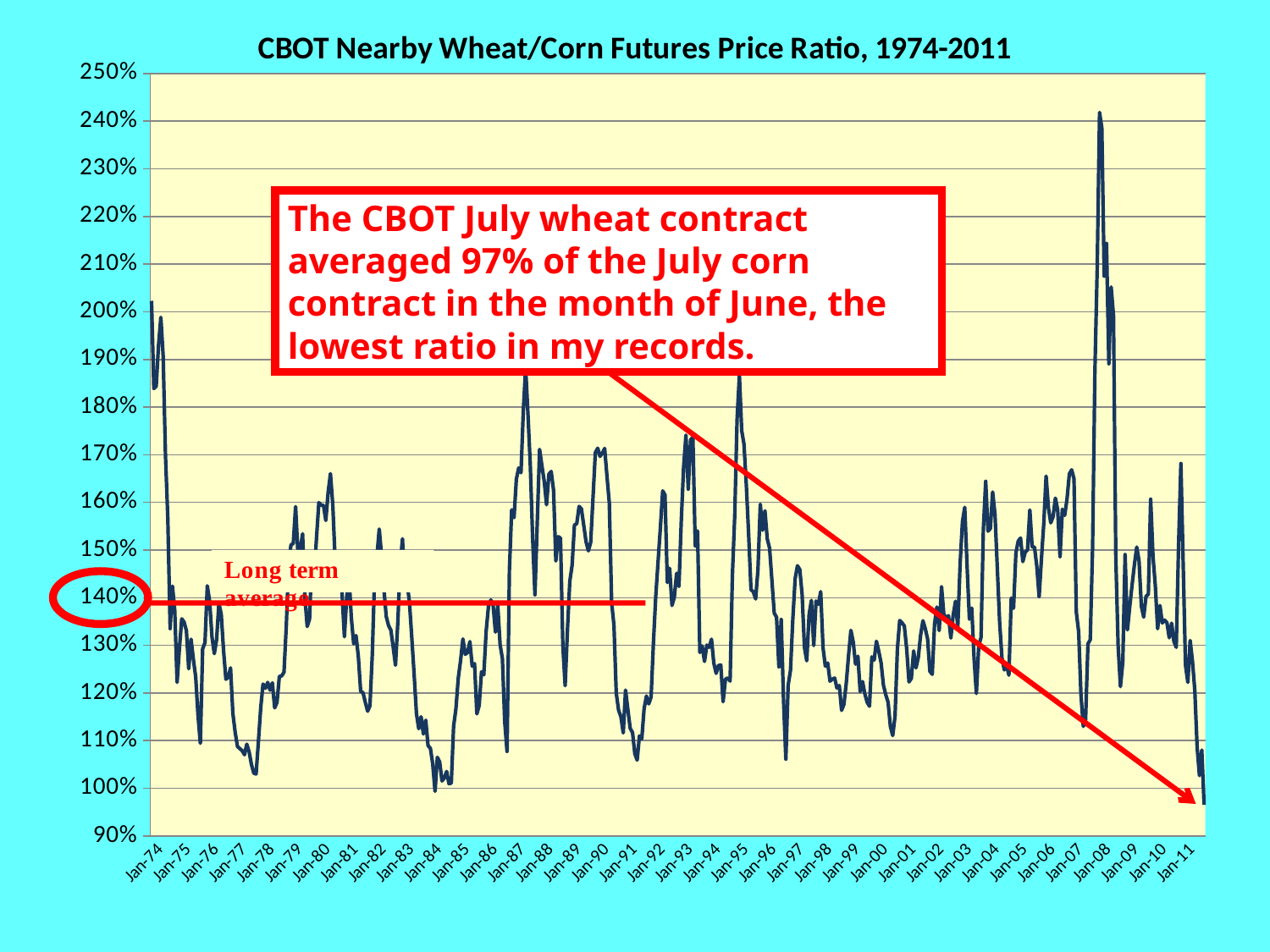
Is the lowest value of the ratio near Jan-84 greater or less than 110%? less Is the value of the ratio at Jan-74 greater or less than 180%? greater What kind of chart is shown on the slide? line chart Around which x-axis label does the wheat/corn ratio reach its highest peak? Jan-08 Is the peak value of the ratio near Jan-08 greater or less than 230%? greater At what value is the 'Long term average' line drawn? 140% Around which x-axis label does the wheat/corn ratio reach its lowest point? Jan-11 What is the highest value shown on the y axis? 250% From the peak near Jan-08 to Jan-11, does the ratio rise or fall? fall What is the title of the chart? CBOT Nearby Wheat/Corn Futures Price Ratio, 1974-2011 According to the annotation, what percentage of the July corn contract did the CBOT July wheat contract average in June? 97%